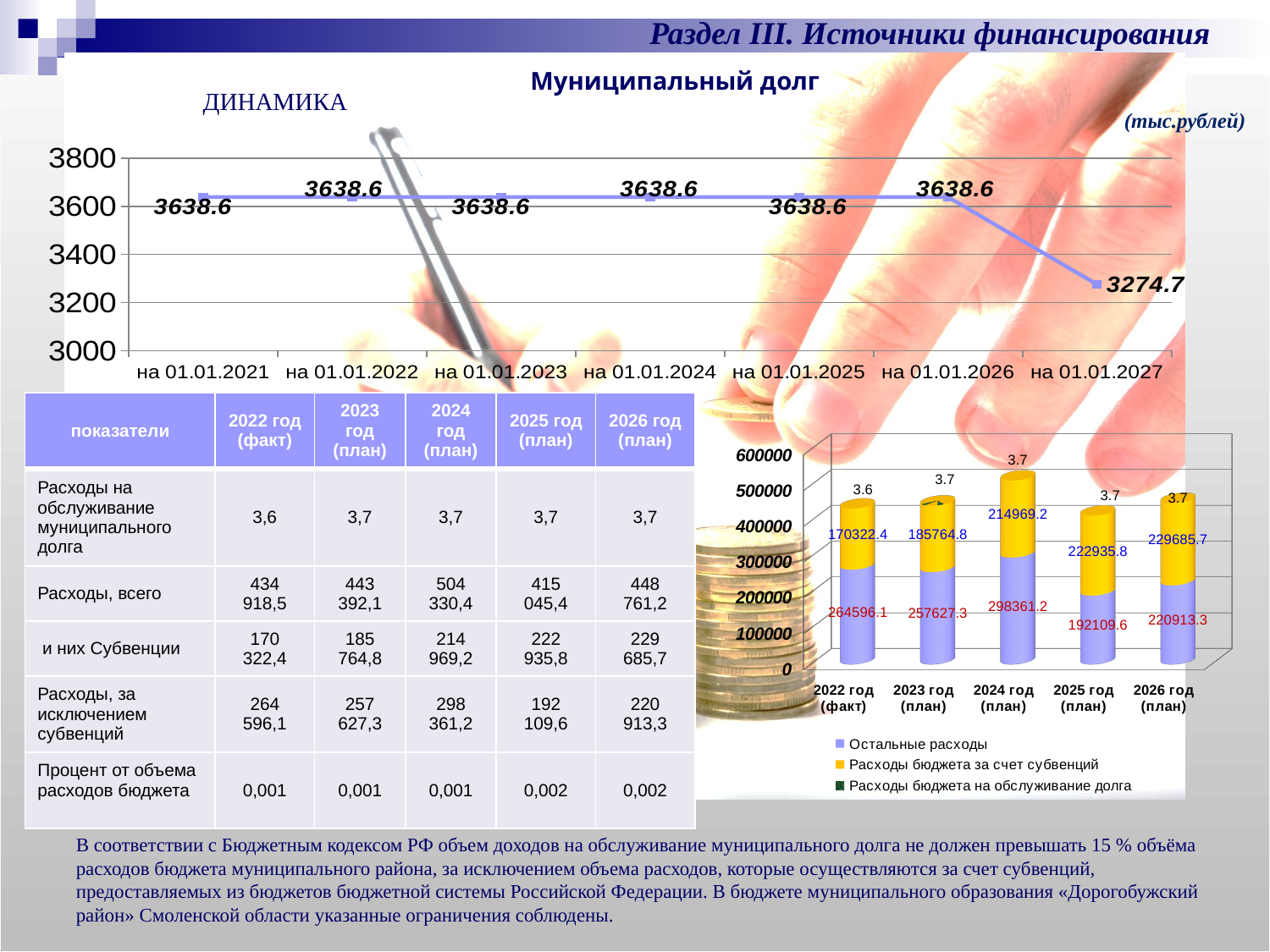
In the line chart titled 'Муниципальный долг', which date has the lowest value? на 01.01.2027 In the line chart titled 'Муниципальный долг', is the value for на 01.01.2027 greater or less than 3400? less In the stacked bar chart at the bottom right, how many series does the legend list? 3 In the line chart titled 'Муниципальный долг', how many dates are plotted on the x axis? 7 In the stacked bar chart at the bottom right, which is larger for 2025 год (план): Остальные расходы or Расходы бюджета за счет субвенций? Расходы бюджета за счет субвенций In the stacked bar chart at the bottom right, which year has the highest value of Остальные расходы? 2024 год (план) In the line chart titled 'Муниципальный долг', what is the value for на 01.01.2024? 3638.6 In the line chart titled 'Муниципальный долг', what is the value for на 01.01.2027? 3274.7 In the line chart titled 'Муниципальный долг', what is the difference between the value for на 01.01.2026 and the value for на 01.01.2027? 363.9 What kind of chart is the chart at the bottom right of the slide? bar chart In the stacked bar chart at the bottom right, what is the value of Остальные расходы for 2024 год (план)? 298361.2 In the stacked bar chart at the bottom right, what is the value of Расходы бюджета за счет субвенций for 2026 год (план)? 229685.7